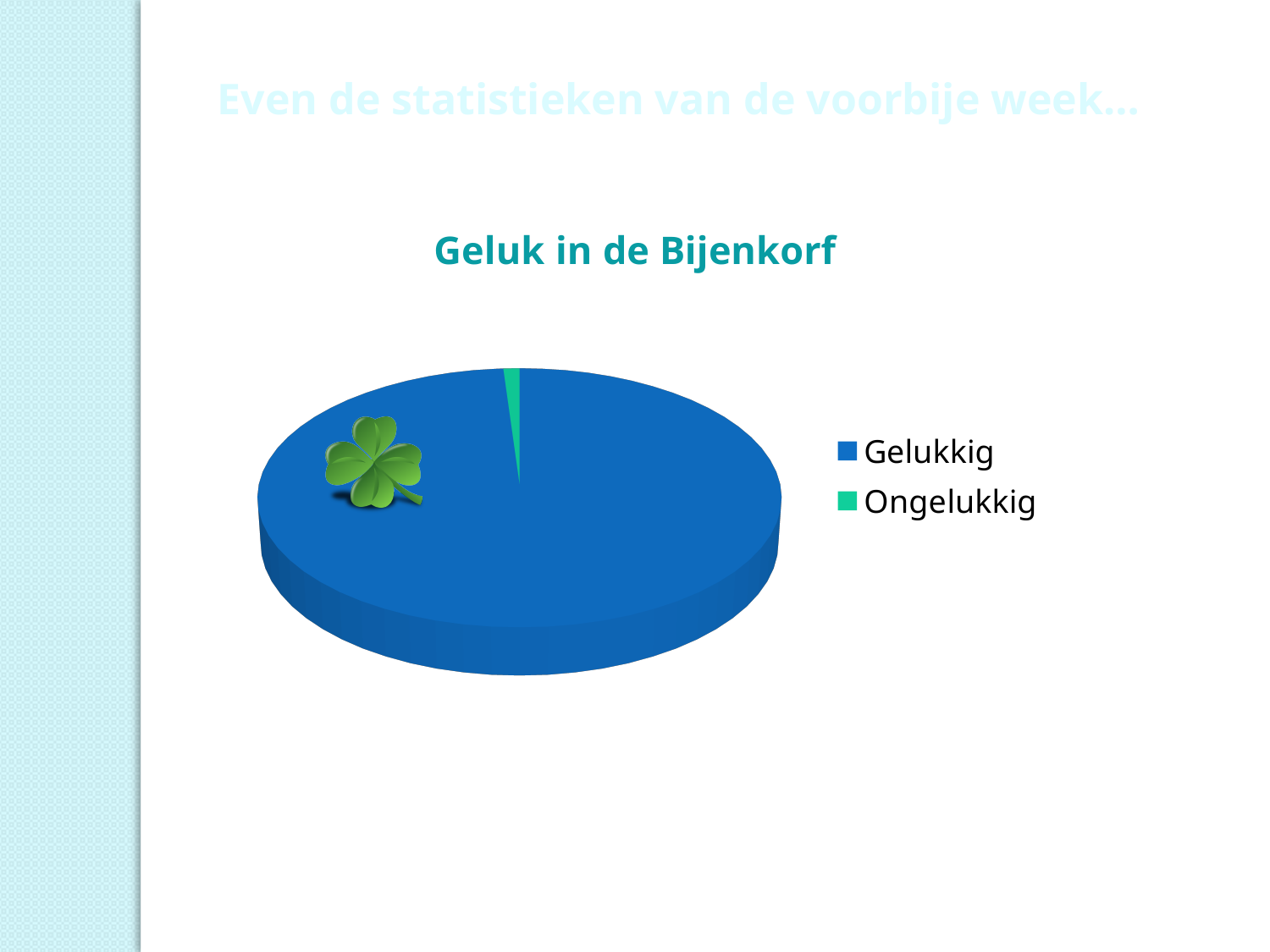
Which slice is larger, Gelukkig or Ongelukkig? Gelukkig Which category has the largest slice of the pie? Gelukkig What is the title of the chart? Geluk in de Bijenkorf What kind of chart is shown on the slide? pie chart How many slices does the pie chart have? 2 How many categories does the legend of the pie chart list? 2 What colour is the Gelukkig slice in the pie chart? blue Which category has the smallest slice of the pie? Ongelukkig